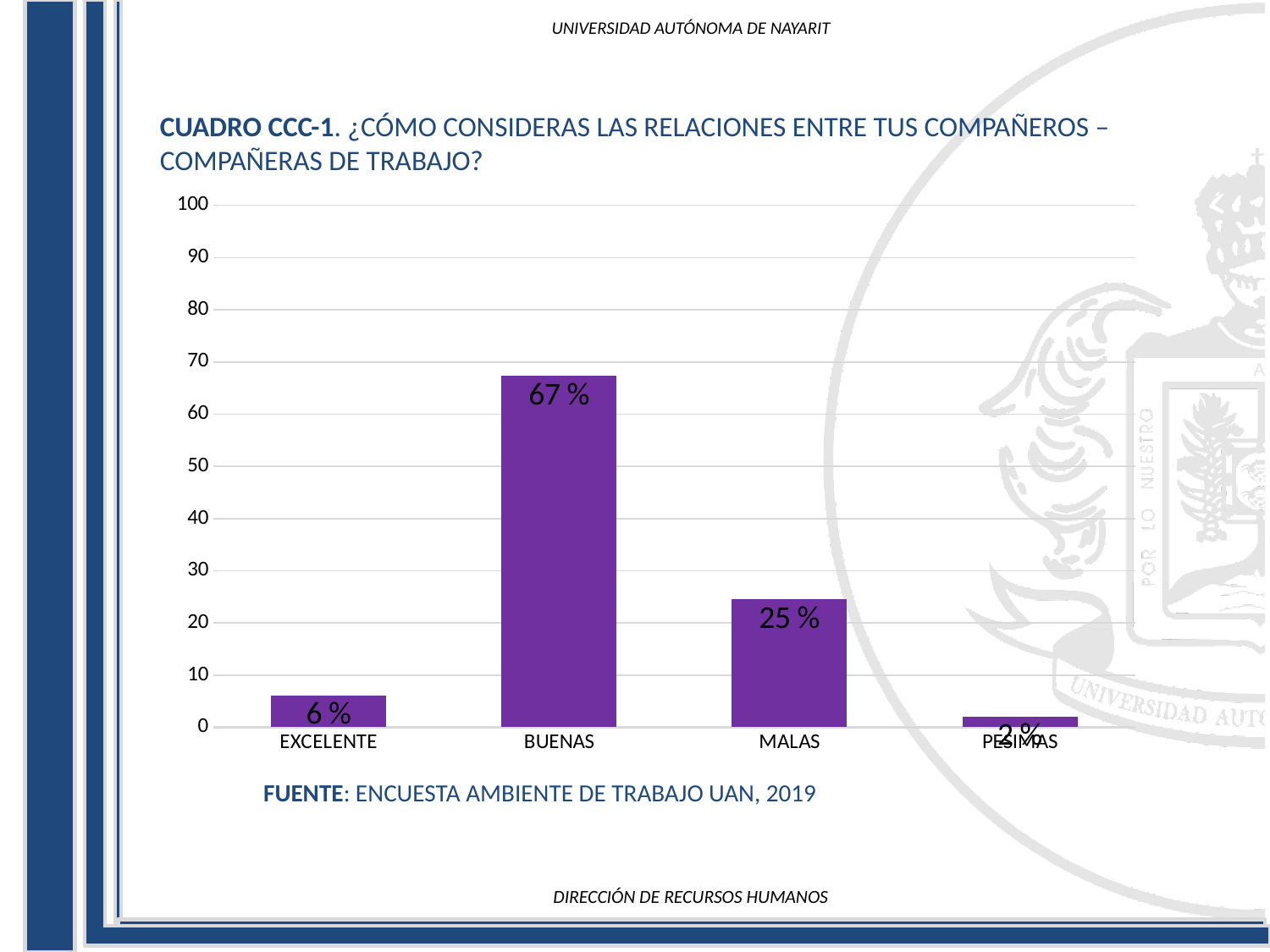
What kind of chart is shown on the slide? bar chart Which is larger, the value for EXCELENTE or the value for MALAS? MALAS What is the value for MALAS? 25 % Is the value for BUENAS greater or less than 60? greater What is the difference between the values for MALAS and EXCELENTE? 19 % Which category has the highest value? BUENAS What is the value for EXCELENTE? 6 % How many categories are shown on the x axis? 4 What is the difference between the values for BUENAS and MALAS? 42 % What source is cited below the chart? ENCUESTA AMBIENTE DE TRABAJO UAN, 2019 What is the value for BUENAS? 67 % Which category has the lowest value? PESIMAS